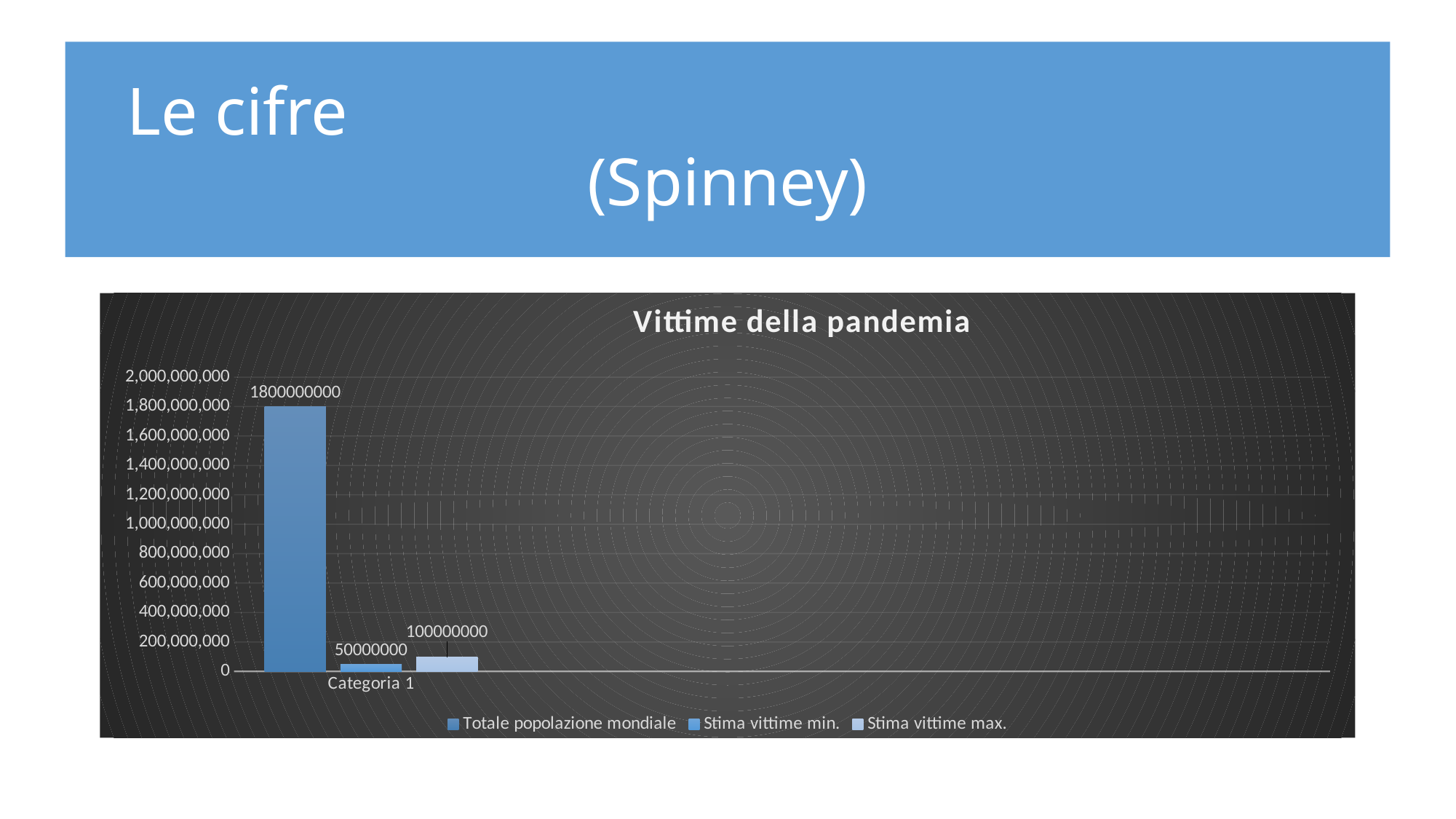
What is the difference between Stima vittime max. and Stima vittime min.? 50000000 Which series has the lowest value? Stima vittime min. How many categories are shown on the x axis? 1 What is the value for Stima vittime max.? 100000000 How many series does the legend list? 3 What is the value for Totale popolazione mondiale? 1800000000 What is the value for Stima vittime min.? 50000000 Is the value for Totale popolazione mondiale greater or less than 1,000,000,000? greater What type of chart is shown on the slide? bar chart Which is larger, Stima vittime max. or Stima vittime min.? Stima vittime max. Which series has the highest value? Totale popolazione mondiale What is the title of the chart? Vittime della pandemia